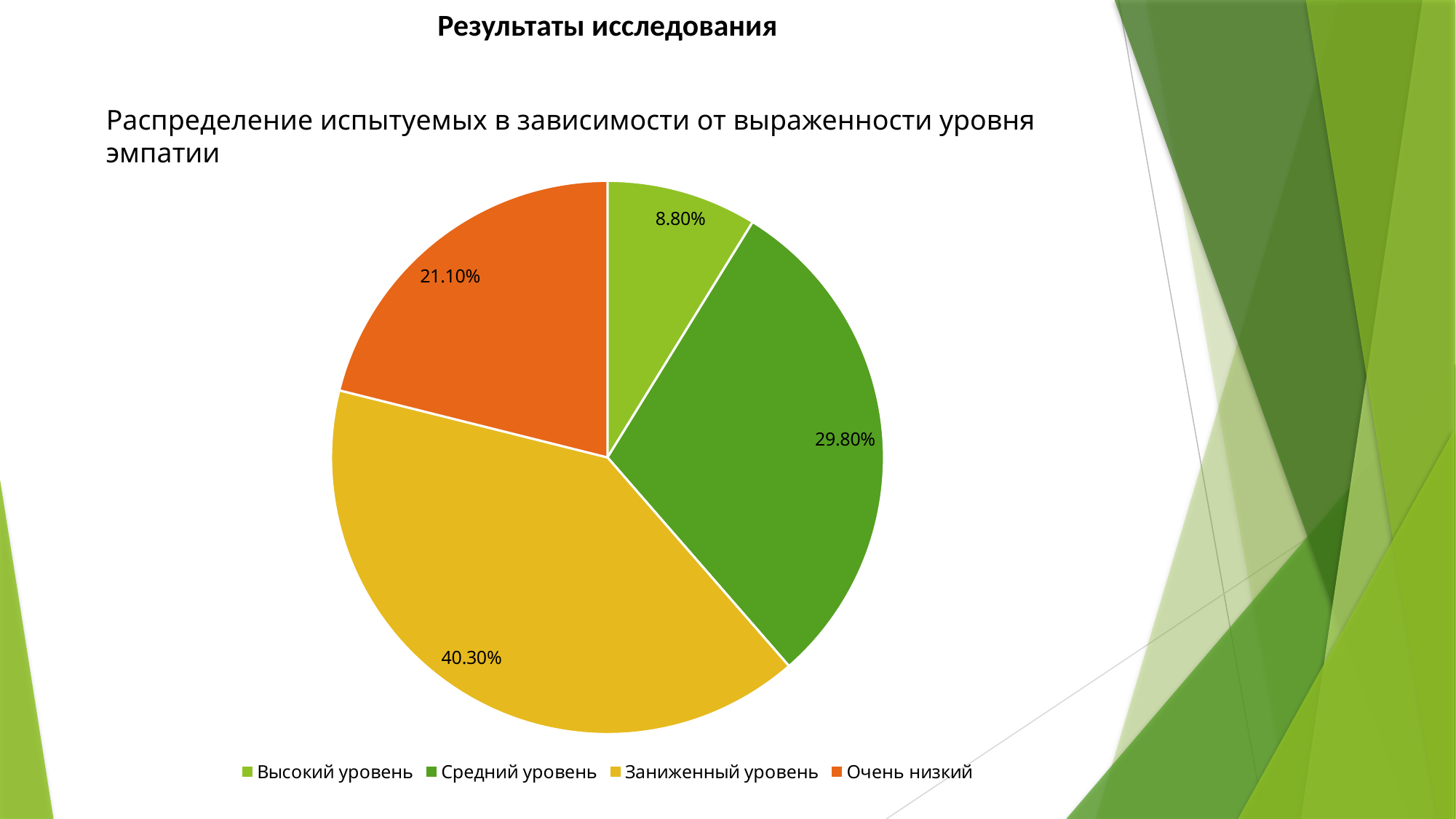
Which category has the largest slice of the pie? Заниженный уровень What is the difference between the shares of "Заниженный уровень" and "Средний уровень"? 10.50% Which is larger: the share of "Средний уровень" or the share of "Очень низкий"? Средний уровень Which category has the smallest slice of the pie? Высокий уровень How many categories does the pie chart have? 4 What share of the pie does "Заниженный уровень" have? 40.30% What share of the pie does "Очень низкий" have? 21.10% What share of the pie does "Высокий уровень" have? 8.80% What is the difference between the shares of "Очень низкий" and "Высокий уровень"? 12.30% What kind of chart is shown on the slide? pie chart What is the title of the chart? Распределение испытуемых в зависимости от выраженности уровня эмпатии